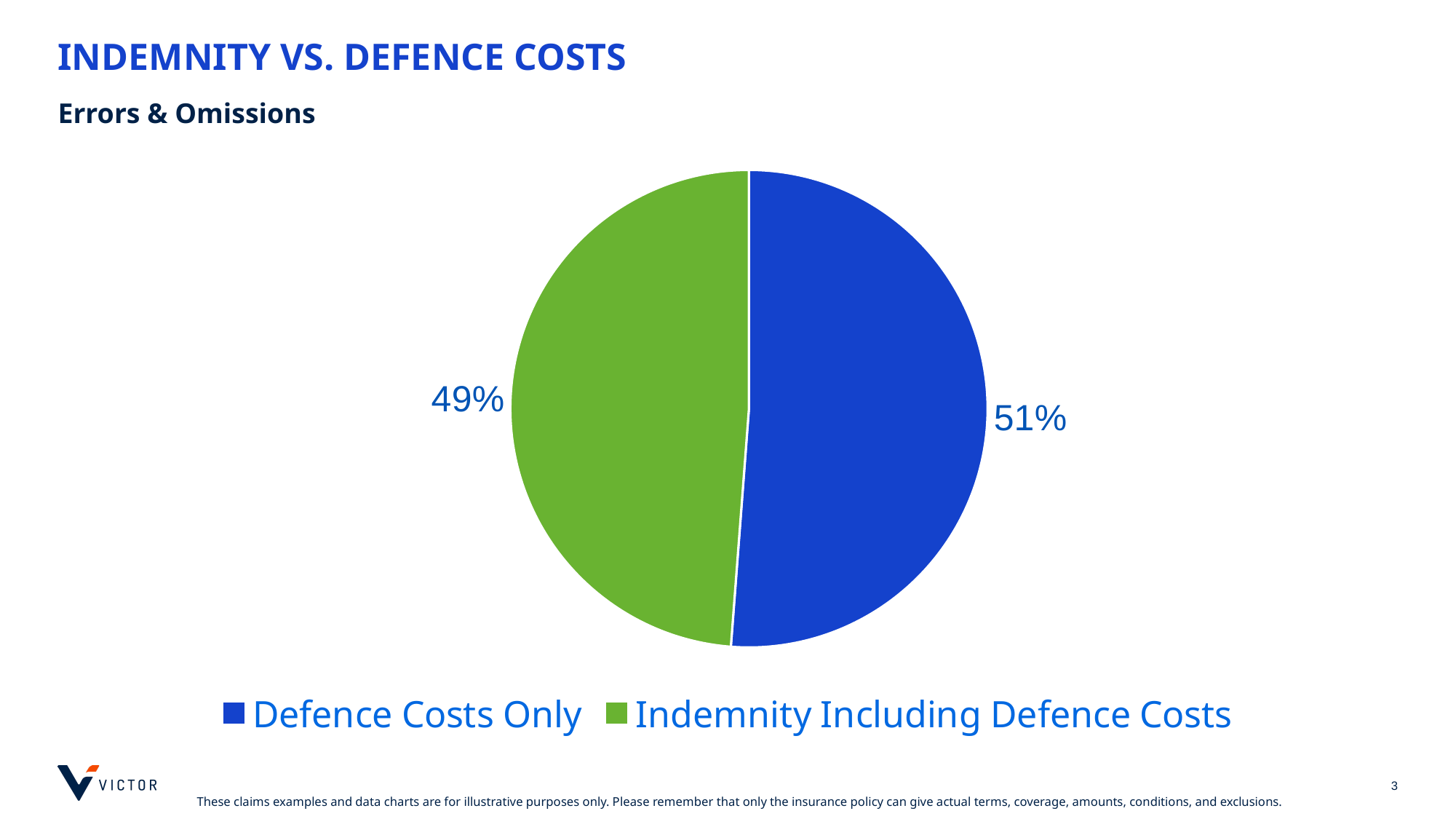
How many slices does the pie chart have? 2 Which slice of the pie is the largest? Defence Costs Only What is the title of the slide containing the pie chart? INDEMNITY VS. DEFENCE COSTS Which slice of the pie is the smallest? Indemnity Including Defence Costs What share of the pie is Defence Costs Only? 51% What is the difference in percentage points between Defence Costs Only and Indemnity Including Defence Costs? 2 percentage points What kind of chart is shown on the slide? pie chart Which is larger, Defence Costs Only or Indemnity Including Defence Costs? Defence Costs Only How many entries does the legend list? 2 What share of the pie is Indemnity Including Defence Costs? 49% Is the share for Indemnity Including Defence Costs greater or less than 50%? less What colour is the Defence Costs Only slice? blue